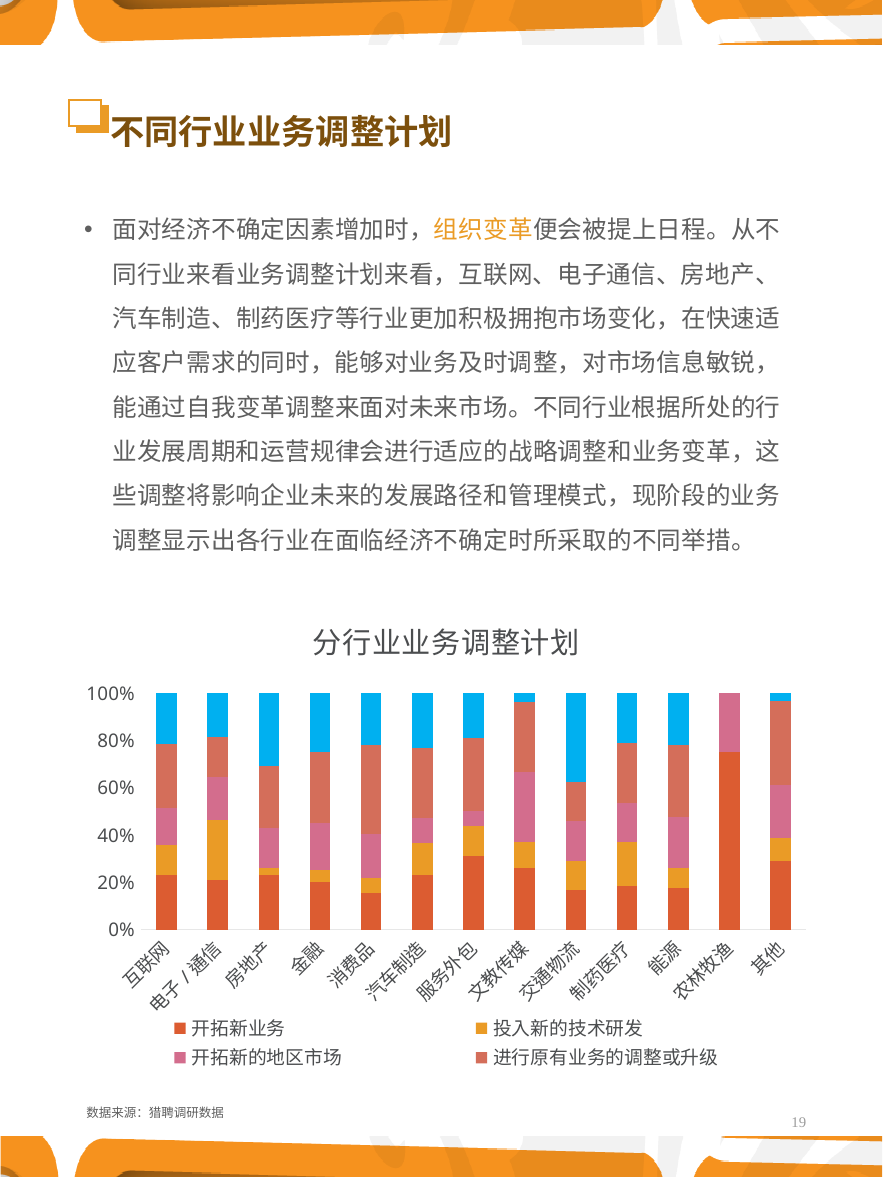
Is the 开拓新业务 share for 农林牧渔 greater or less than 60%? greater Which has a larger 开拓新业务 share, 农林牧渔 or 互联网? 农林牧渔 How many series does the chart's legend list? 4 What kind of chart is shown on the slide? Stacked bar chart What is the title of the chart? 分行业业务调整计划 Is the 开拓新业务 share for 消费品 greater or less than 20%? less Which industry has the largest share for 开拓新业务? 农林牧渔 Is the 开拓新业务 share for 服务外包 greater or less than 20%? greater Which has a larger 开拓新业务 share, 服务外包 or 消费品? 服务外包 What is the maximum value shown on the chart's y axis? 100% How many industry categories are shown on the x axis of the chart? 13